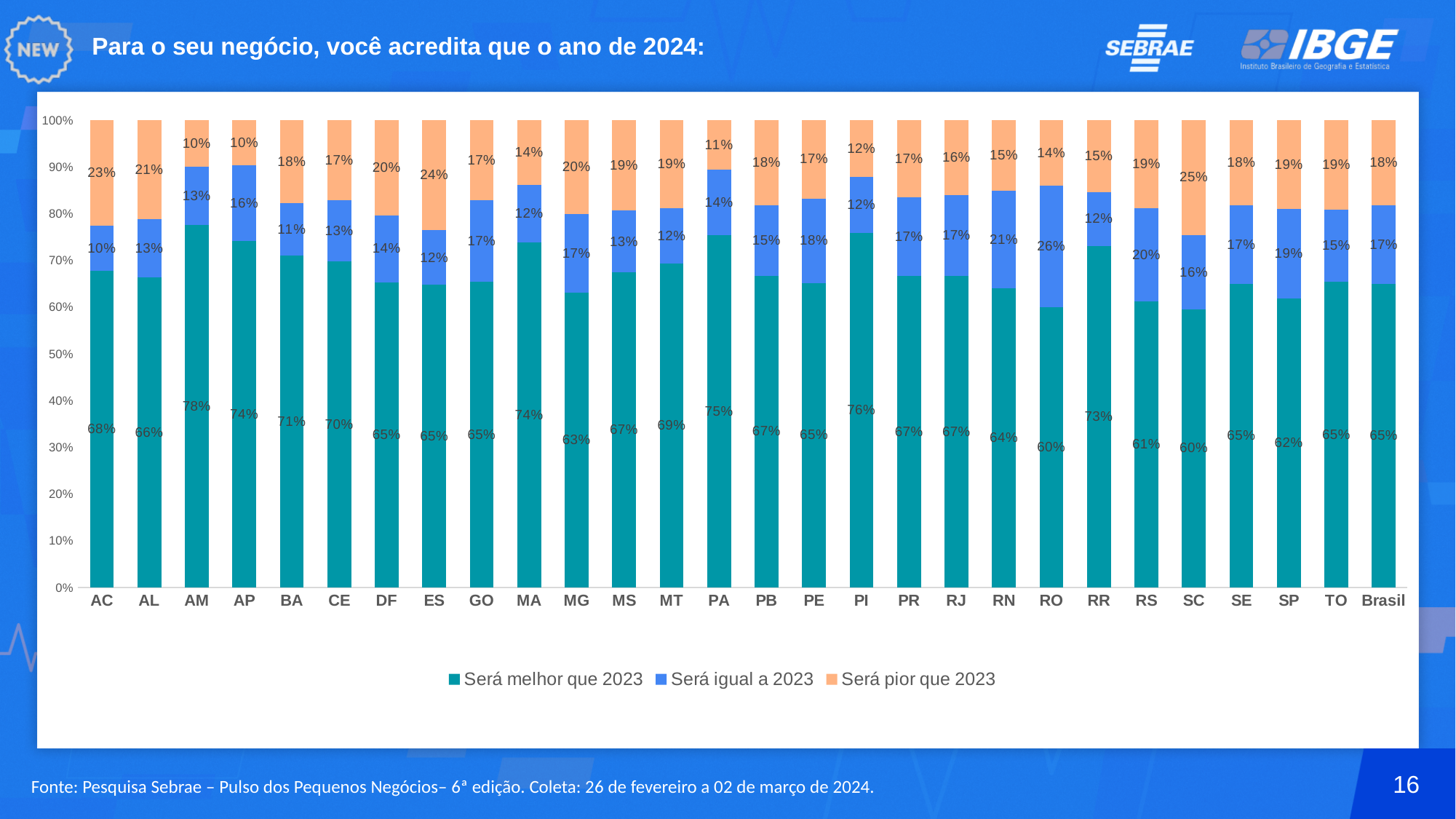
How many categories are shown on the x axis? 28 What is the value of 'Será igual a 2023' for RO? 26% Which is larger, the 'Será pior que 2023' value for AC or for PA? AC What is the difference between the 'Será melhor que 2023' values for AM and SC? 18% How many series does the legend list? 3 Which category has the highest value for 'Será pior que 2023'? SC What is the value of 'Será melhor que 2023' for Brasil? 65% Which category has the highest value for 'Será melhor que 2023'? AM Which series is shown in orange in the legend? Será pior que 2023 What is the value of 'Será pior que 2023' for ES? 24% Which category has the highest value for 'Será igual a 2023'? RO What type of chart is shown on the slide? stacked bar chart